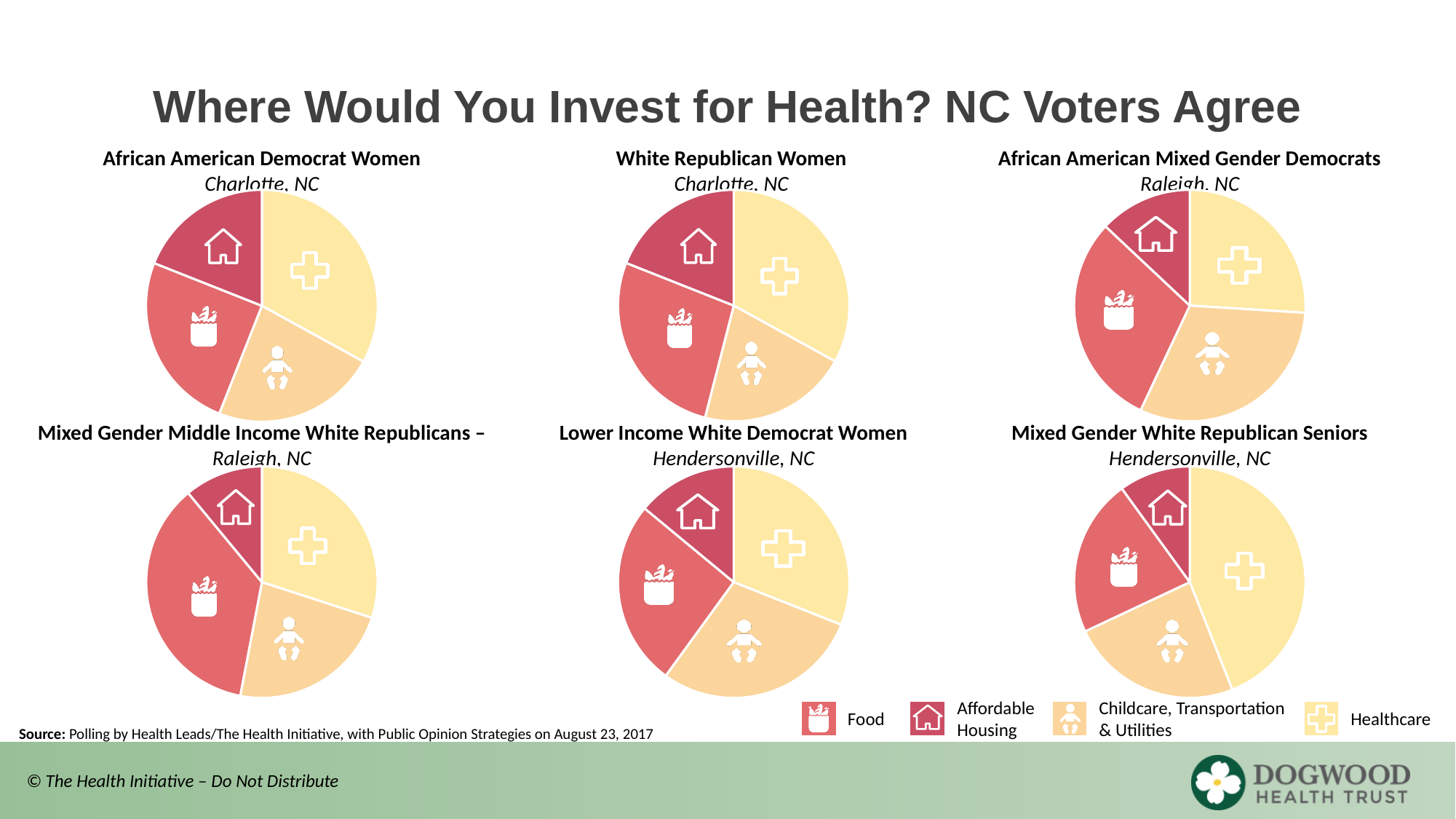
In the 'Mixed Gender White Republican Seniors' pie chart, which category has the smallest slice? Affordable Housing What is the title of the slide? Where Would You Invest for Health? NC Voters Agree In the 'Mixed Gender White Republican Seniors' pie chart, which slice is larger: Food or Healthcare? Healthcare How many pie charts are on the slide? 6 In the 'White Republican Women' pie chart, which slice is larger: Healthcare or Affordable Housing? Healthcare How many categories does the legend list? 4 Which category is shown in yellow in the legend? Healthcare How many slices does each pie chart have? 4 In the 'Mixed Gender White Republican Seniors' pie chart, which category has the largest slice? Healthcare What kind of charts are shown on the slide? Pie charts In the 'African American Democrat Women' pie chart, which category has the smallest slice? Affordable Housing In the 'African American Democrat Women' pie chart, which category has the largest slice? Healthcare